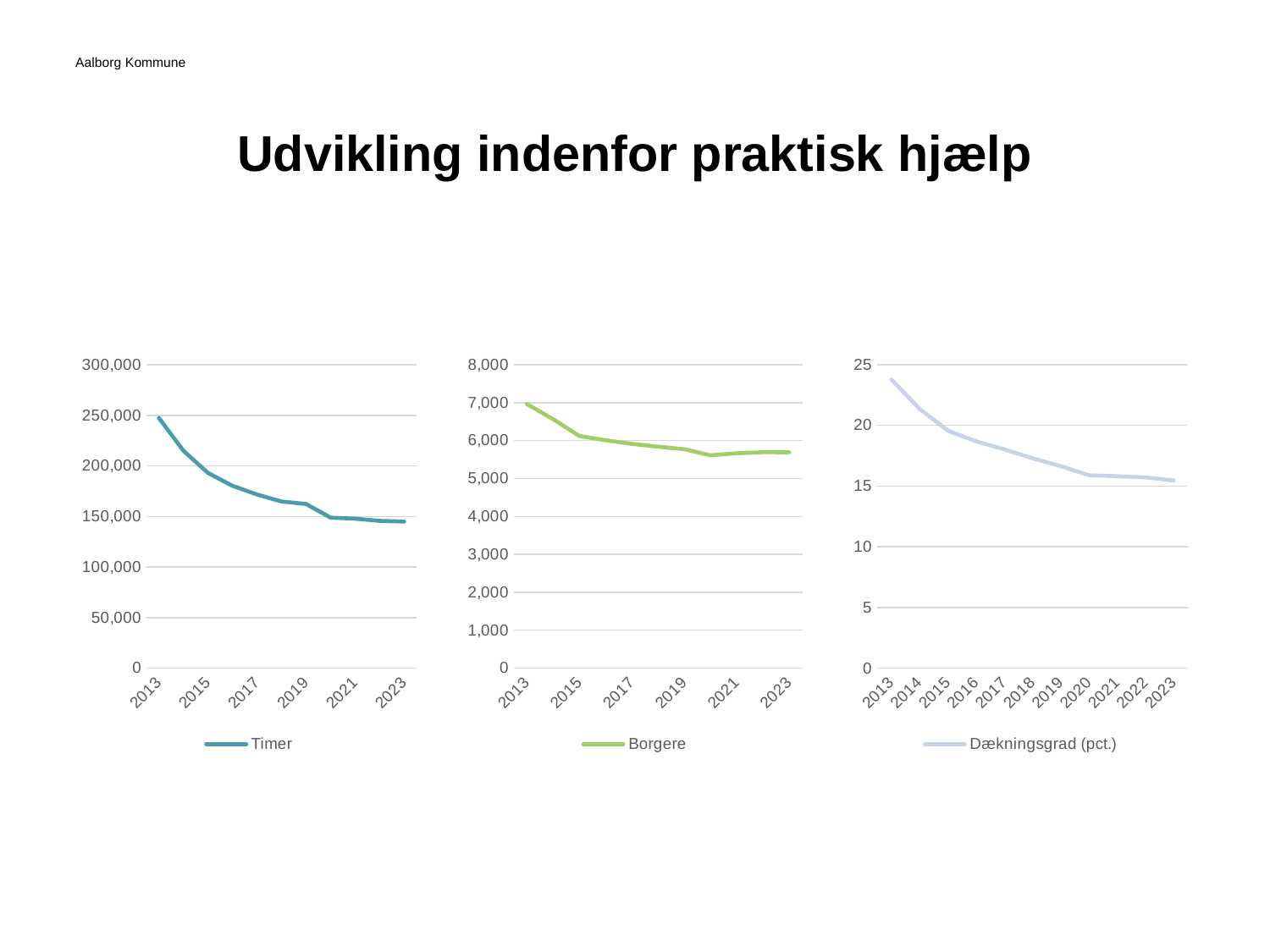
In the left chart (Timer), is the value for 2023 greater or less than 200,000? less In the right chart (Dækningsgrad (pct.)), is the value for 2013 greater or less than 20? greater How many series does the legend of the right chart list? 1 In the right chart (Dækningsgrad (pct.)), is the value for 2016 greater or less than 20? less In the right chart (Dækningsgrad (pct.)), which year has the highest value? 2013 What kind of chart is the left chart with the 'Timer' series? line chart In the left chart (Timer), which year has the highest value? 2013 In the middle chart (Borgere), do the values rise or fall overall from 2013 to 2023? fall In the left chart (Timer), do the values rise or fall from 2013 to 2023? fall